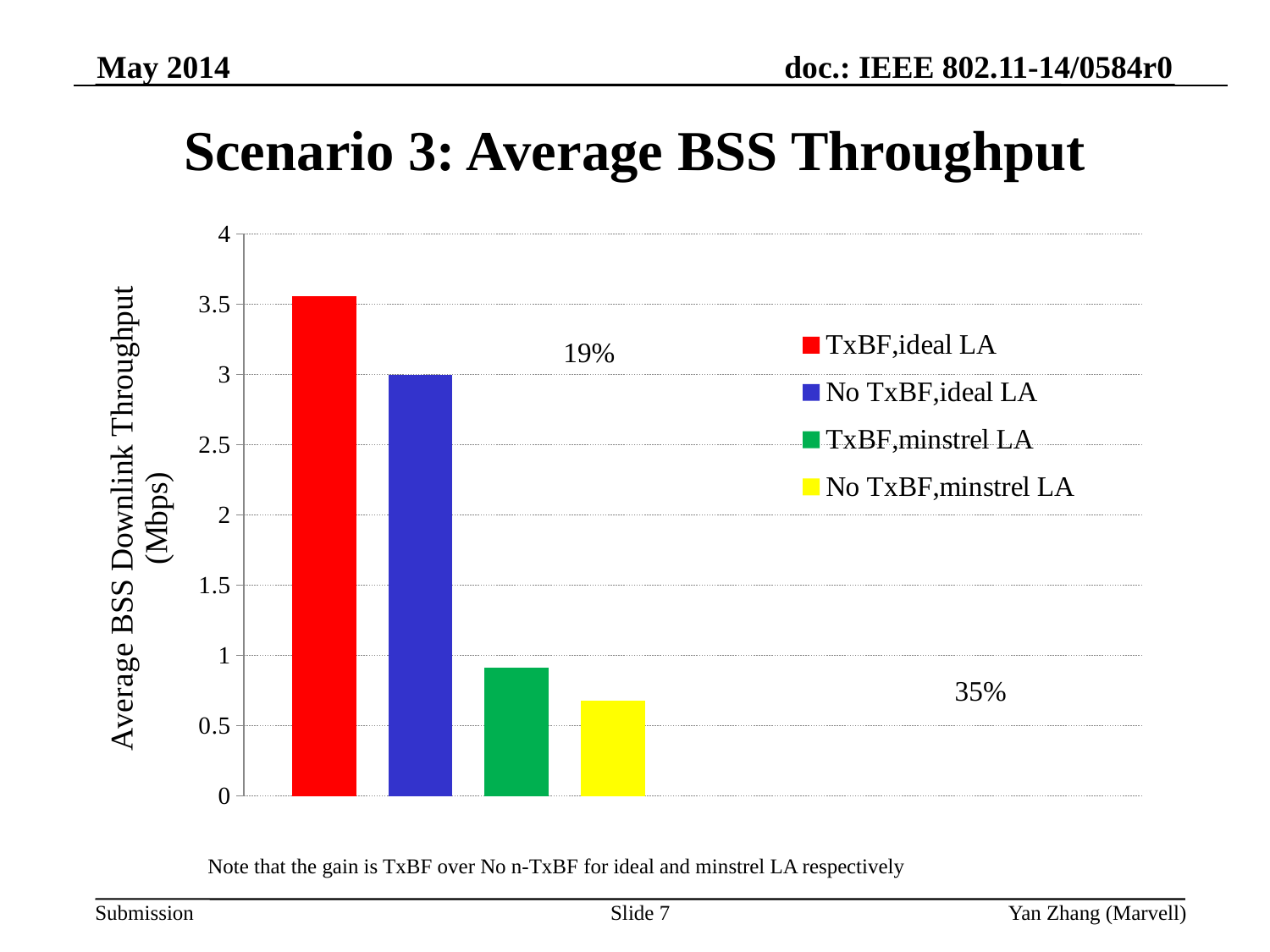
What is the label of the vertical axis? Average BSS Downlink Throughput (Mbps) Is the value for No TxBF,minstrel LA greater or less than 0.5? greater How many series does the legend list? 4 Which is larger, the throughput for TxBF,ideal LA or for No TxBF,ideal LA? TxBF,ideal LA What gain percentage is annotated on the chart for the minstrel LA case? 35% What gain percentage is annotated on the chart for the ideal LA case? 19% Which series has the lowest average BSS downlink throughput? No TxBF,minstrel LA Which series has the highest average BSS downlink throughput? TxBF,ideal LA Which is larger, the throughput for TxBF,minstrel LA or for No TxBF,minstrel LA? TxBF,minstrel LA What kind of chart is shown on the slide? bar chart Is the value for TxBF,minstrel LA greater or less than 1? less Is the value for TxBF,ideal LA greater or less than 3.5? greater